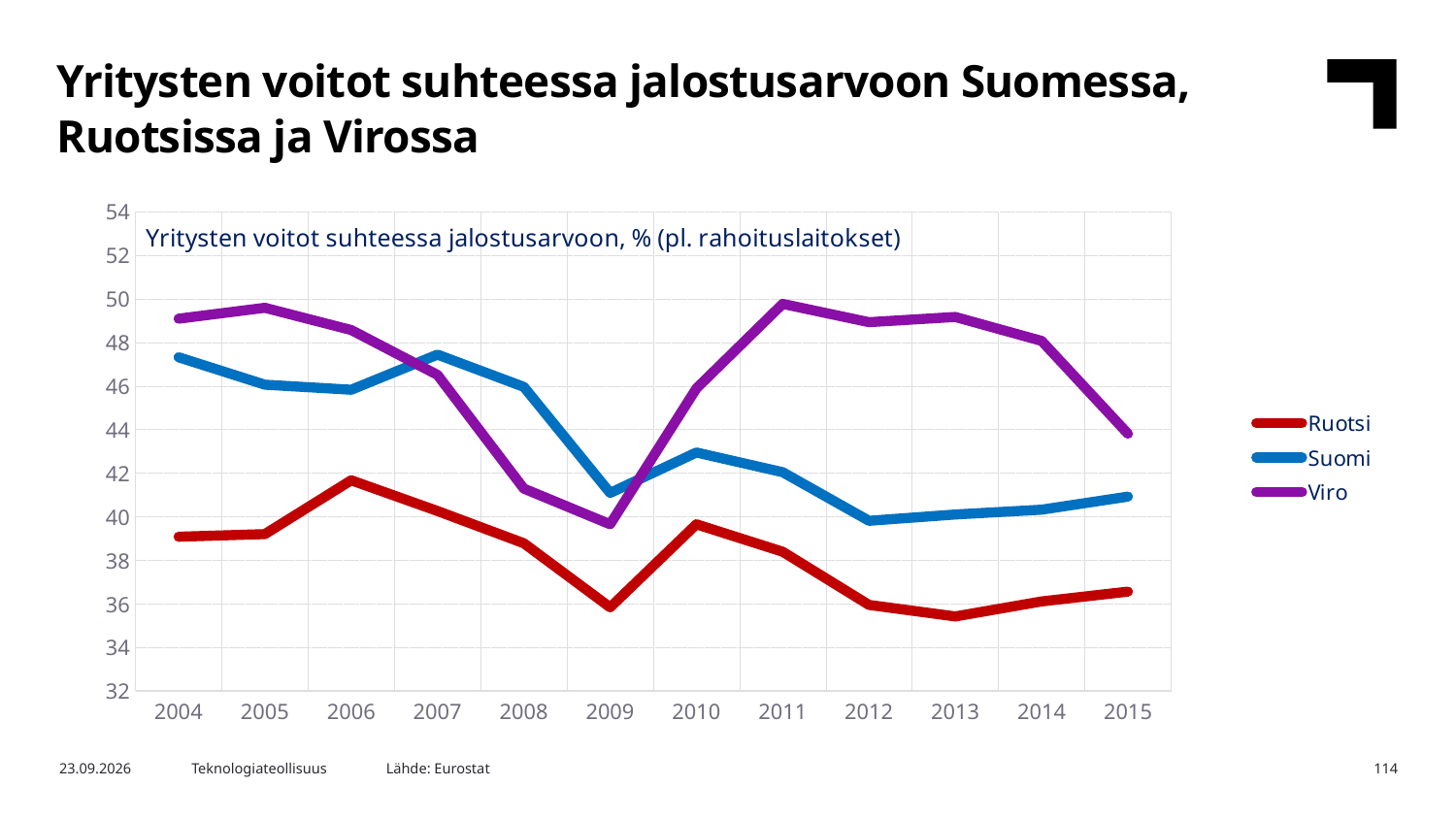
How many years are plotted along the x axis? 12 Which series is lowest in 2015? Ruotsi In which year does the Viro line reach its lowest value? 2009 In 2008, which is larger: the value for Suomi or the value for Viro? Suomi Is the value for Viro in 2011 greater or less than 48? greater Is the value for Ruotsi in 2009 greater or less than 38? less How many series does the legend list? 3 Is the value for Viro in 2015 greater or less than 46? less Does the Viro line rise or fall from 2011 to 2015? fall What is the title printed inside the chart area? Yritysten voitot suhteessa jalostusarvoon, % (pl. rahoituslaitokset) What kind of chart is shown on the slide? line chart In which year does the Ruotsi line reach its highest value? 2006